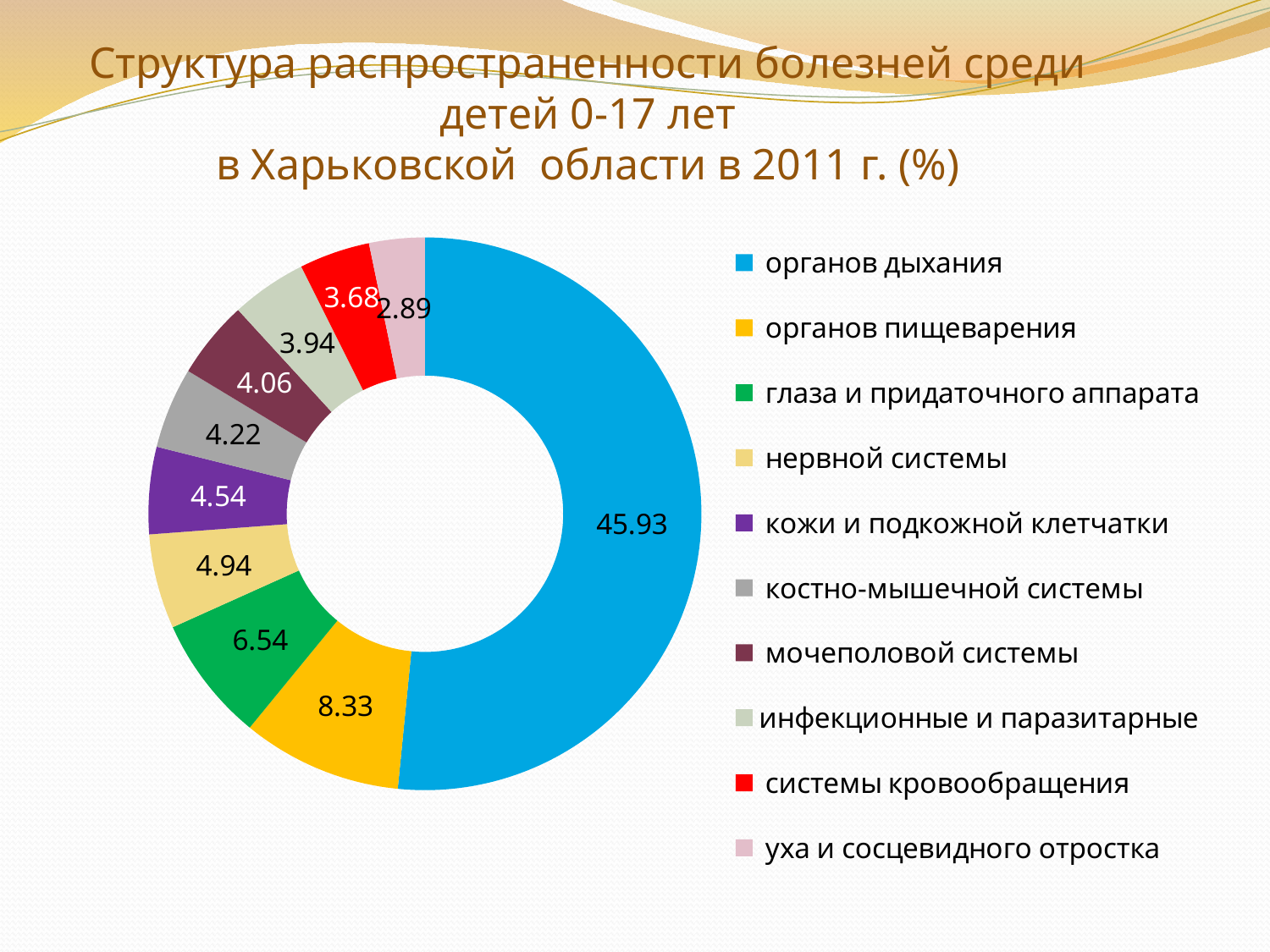
What colour is the segment for системы кровообращения? red How many categories does the chart show? 10 What is the value for уха и сосцевидного отростка? 2.89 Which category has the smallest share of the chart? уха и сосцевидного отростка What is the value for органов дыхания? 45.93 Which category has the largest share of the chart? органов дыхания Which is larger, the value for нервной системы or the value for костно-мышечной системы? нервной системы What is the difference between the values for органов пищеварения and глаза и придаточного аппарата? 1.79 What kind of chart is shown on the slide? doughnut chart What is the value for глаза и придаточного аппарата? 6.54 What is the value for кожи и подкожной клетчатки? 4.54 What is the value for органов пищеварения? 8.33